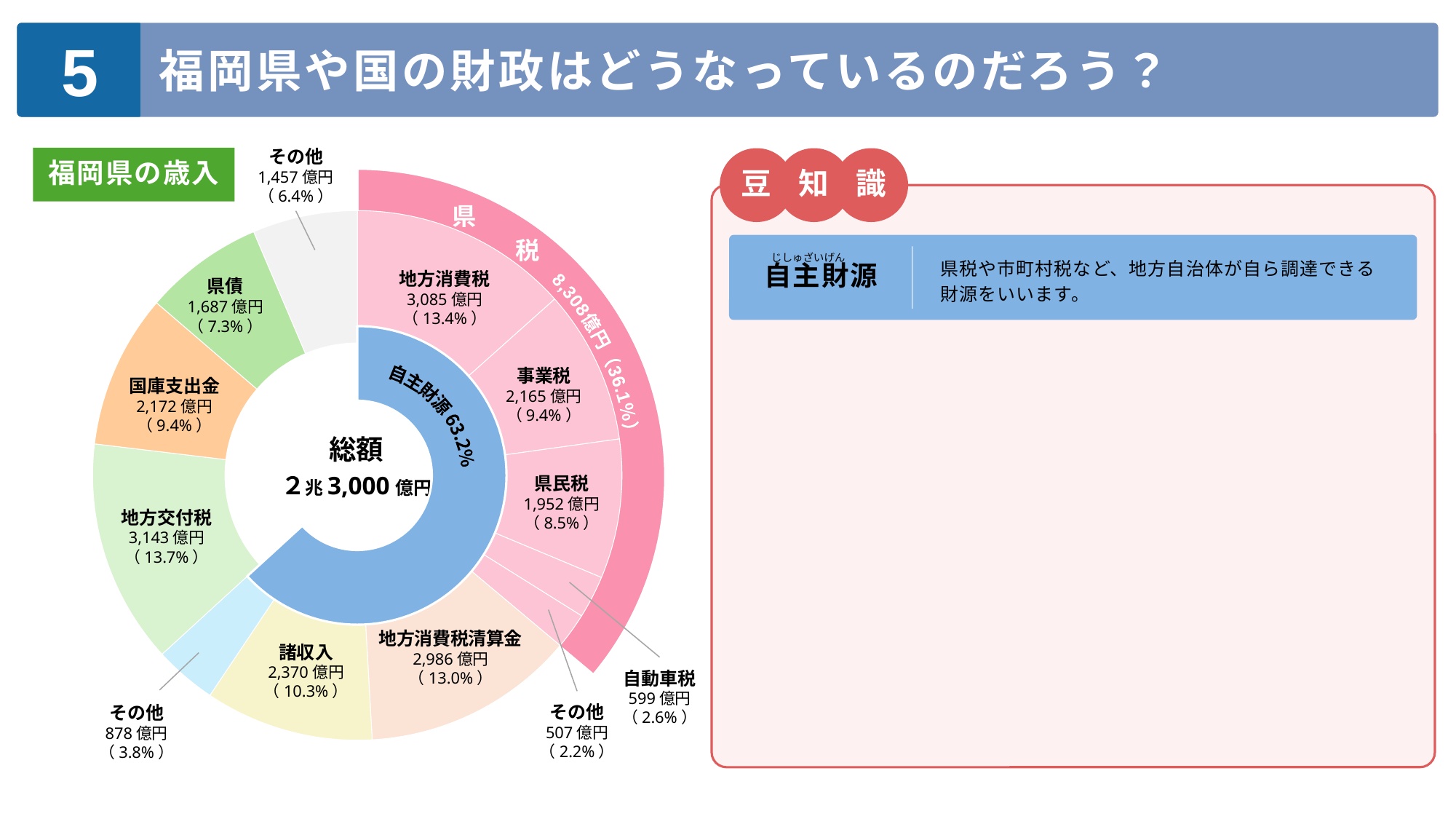
In the 福岡県の歳入 chart, what is the difference between 国庫支出金 and 県債? 485億円 In the 福岡県の歳入 chart, what is the value for 自動車税? 599億円 What is the total amount (総額) shown in the center of the 福岡県の歳入 chart? 2兆3,000億円 In the 福岡県の歳入 chart, what percentage share does 県税 account for? 36.1% In the 福岡県の歳入 chart, what is the value for 県債? 1,687億円 In the 福岡県の歳入 chart, what is the percentage share of 諸収入? 10.3% In the 福岡県の歳入 chart, what percentage does 自主財源 represent? 63.2% In the 福岡県の歳入 chart, which is larger: 地方消費税 or 地方消費税清算金? 地方消費税 In the 福岡県の歳入 chart, what is the value for 地方交付税? 3,143億円 What type of chart is used to show 福岡県の歳入? Donut (pie) chart In the 福岡県の歳入 chart, which of the individual outer-ring categories has the largest value? 地方交付税 In the 福岡県の歳入 chart, what is the difference between 事業税 and 県民税? 213億円